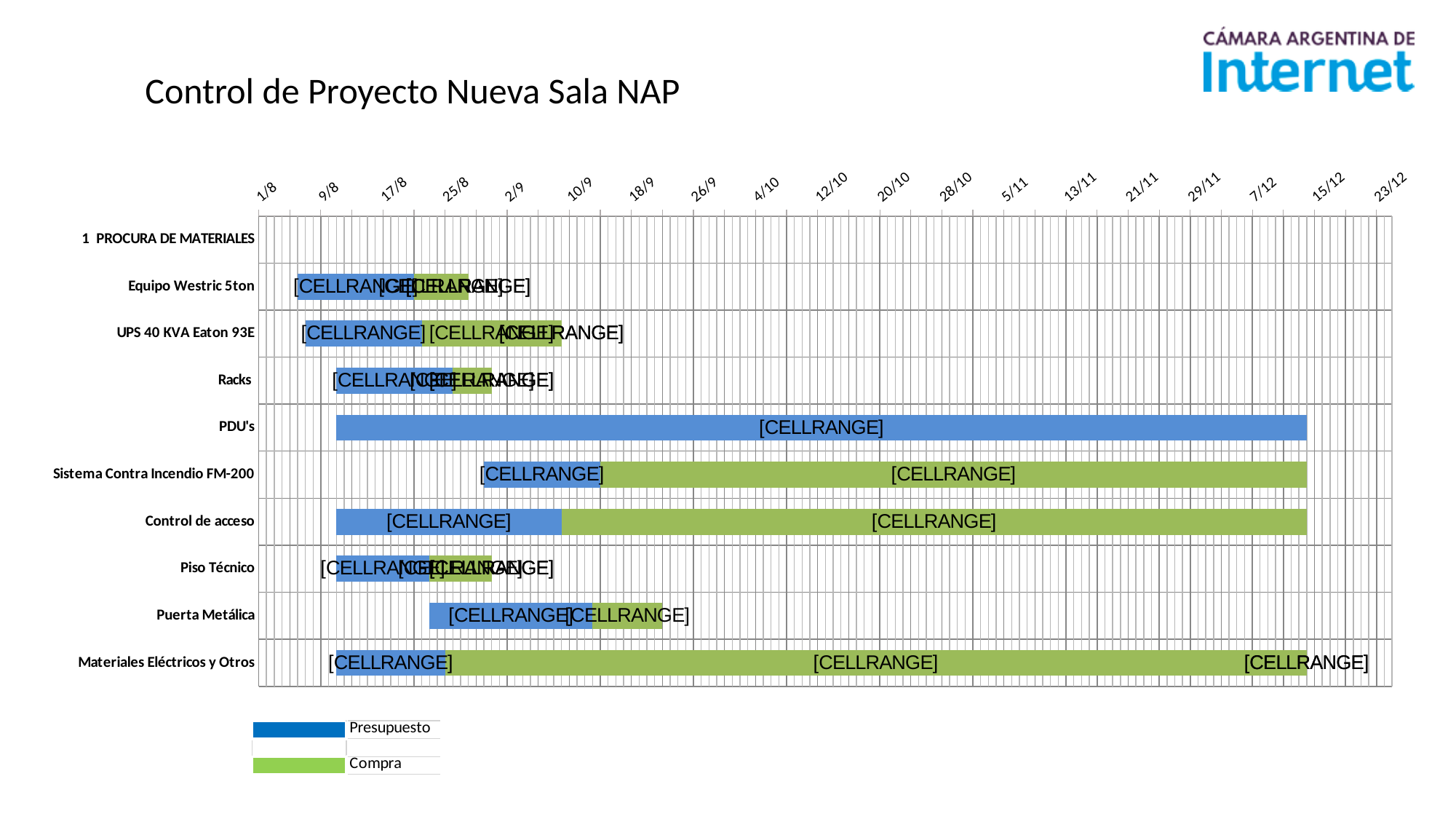
Does the bar for Puerta Metálica end before or after 26/9? before Which task has the longer total bar, Racks or Sistema Contra Incendio FM-200? Sistema Contra Incendio FM-200 Does the bar for Racks extend past 10/9? no What kind of chart is shown on the slide? Bar chart (Gantt-style horizontal bar chart) Which task shows only a Presupuesto (blue) bar and no Compra (green) bar? PDU's How many task rows on the chart have bars plotted? 9 Which colour represents the Compra series? Green What are the two series named in the legend? Presupuesto and Compra How many series does the legend list? 2 Which task has the longer total bar, Puerta Metálica or Control de acceso? Control de acceso Does the bar for PDU's extend past 7/12? yes